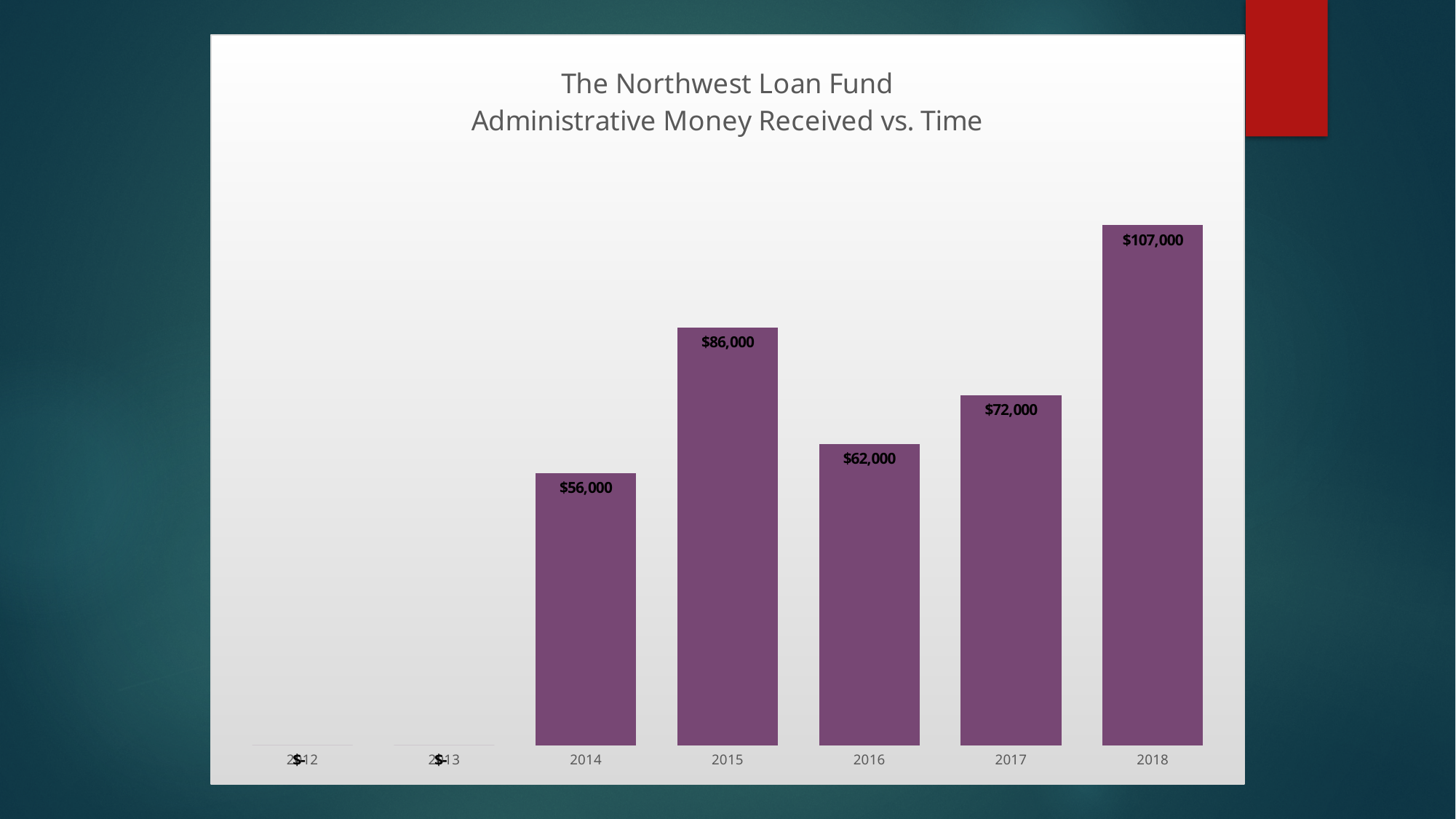
Which year received more administrative money, 2015 or 2017? 2015 What is the administrative money received in 2014? $56,000 What is the administrative money received in 2016? $62,000 What is the administrative money received in 2017? $72,000 What is the difference between the administrative money received in 2018 and in 2015? $21,000 Among the years with a visible bar, which year has the lowest administrative money received? 2014 What is the difference between the administrative money received in 2017 and in 2016? $10,000 Which year has the highest administrative money received? 2018 What is the administrative money received in 2018? $107,000 How many years are shown on the x axis of the chart? 7 What kind of chart is shown on the slide? Bar chart What is the title of the chart? The Northwest Loan Fund Administrative Money Received vs. Time